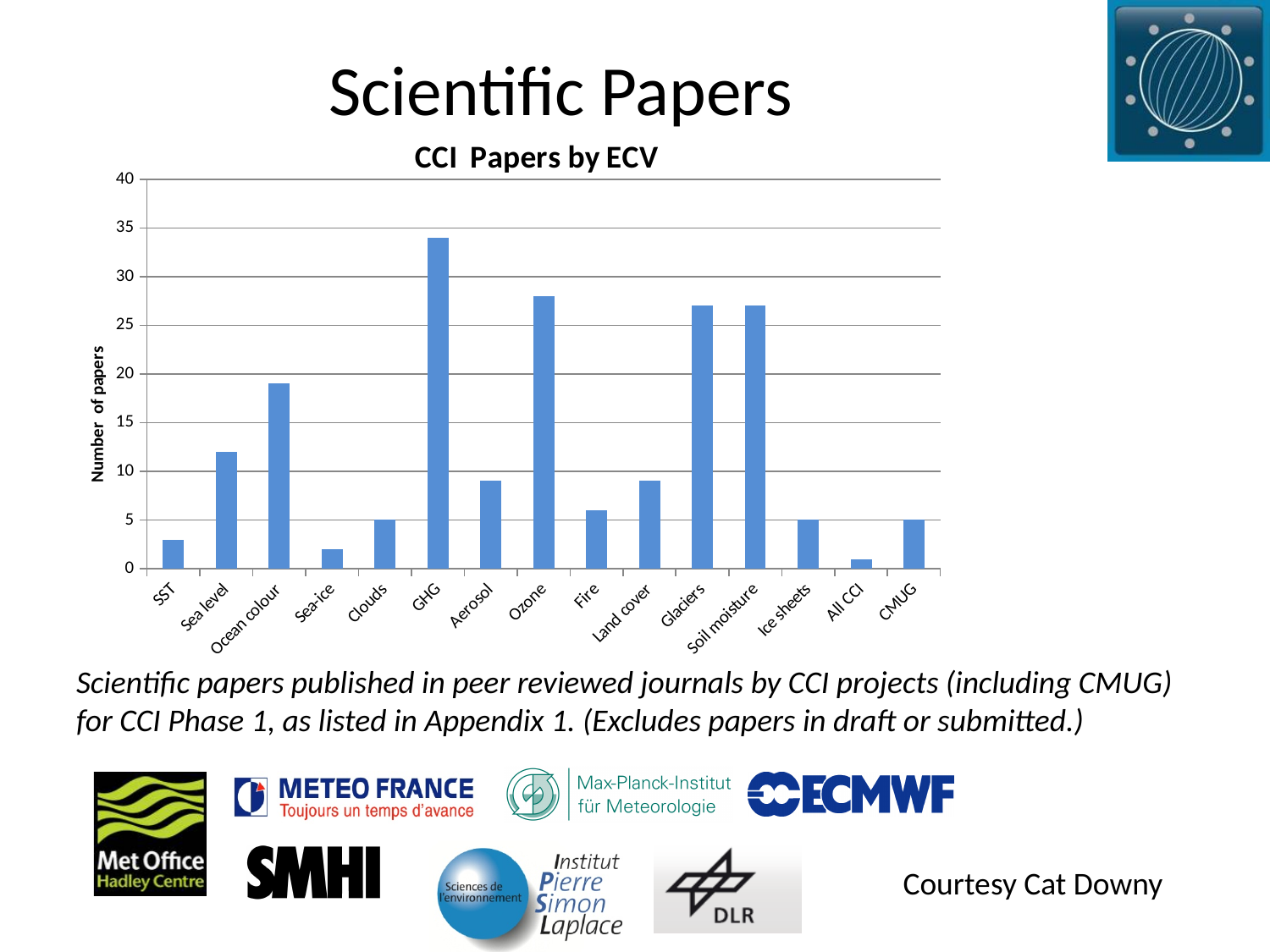
What is the number of papers for Clouds? 5 Which category has the lowest number of papers? All CCI Is the value for GHG greater or less than 30? greater What type of chart is shown on the slide? bar chart Is the value for Sea level greater or less than 15? less What is the label of the vertical axis? Number of papers What is the number of papers for CMUG? 5 Which has more papers, GHG or Ozone? GHG Which has more papers, Ocean colour or Sea level? Ocean colour How many categories are shown on the x axis? 15 Which category has the highest number of papers? GHG What is the title of the chart? CCI Papers by ECV